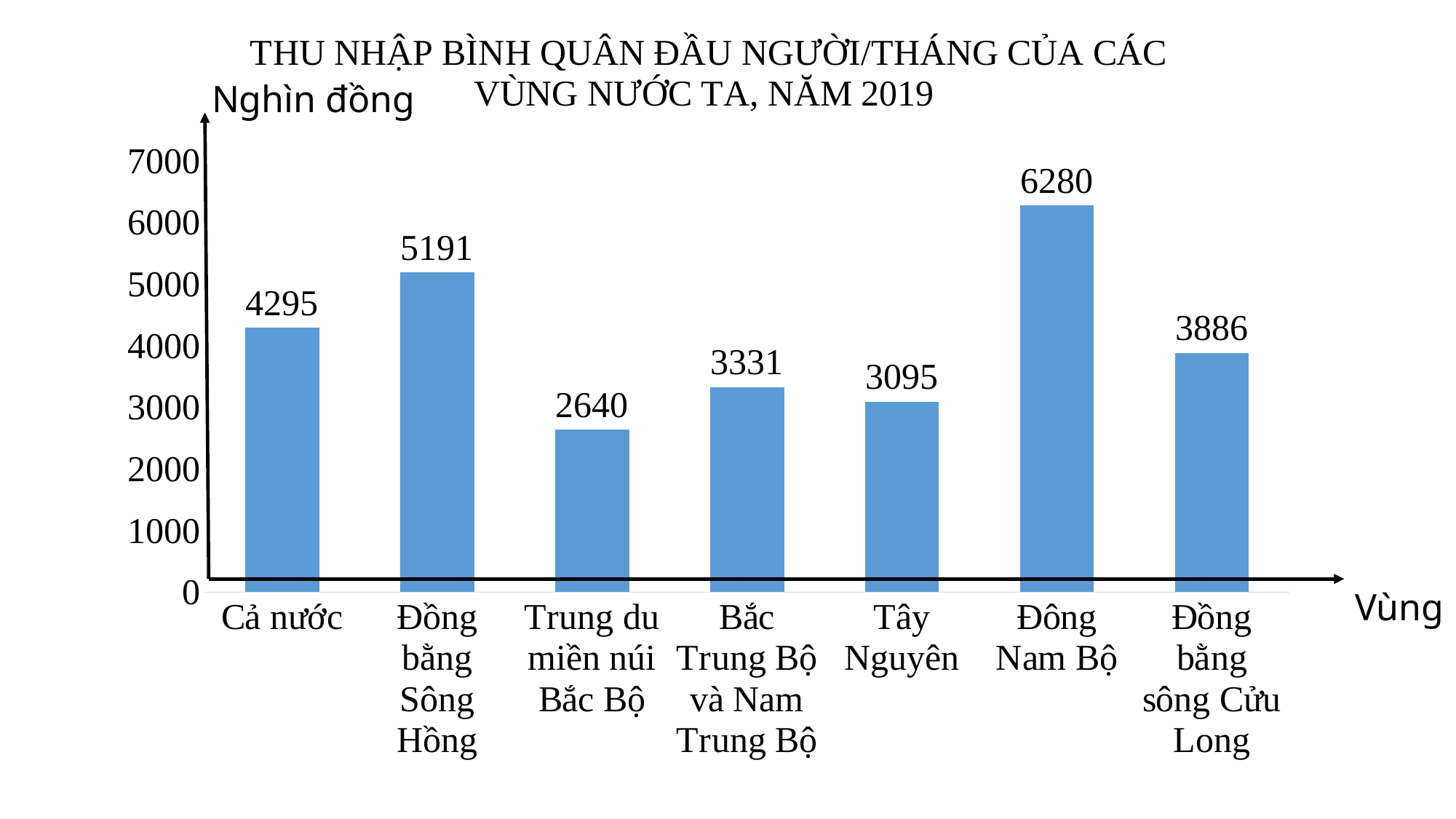
Which region has the highest value? Đông Nam Bộ Which is larger, the value for Bắc Trung Bộ và Nam Trung Bộ or the value for Tây Nguyên? Bắc Trung Bộ và Nam Trung Bộ What is the difference between the values for Đồng bằng Sông Hồng and Tây Nguyên? 2096 What is the difference between the values for Đông Nam Bộ and Cả nước? 1985 What is the value for Đồng bằng sông Cửu Long? 3886 Which region has the lowest value? Trung du miền núi Bắc Bộ What unit is shown on the vertical axis? Nghìn đồng What kind of chart is this? bar chart Is the value for Đồng bằng Sông Hồng greater or less than 5000? greater What is the value for Đông Nam Bộ? 6280 How many categories are shown on the x axis? 7 What is the value for Trung du miền núi Bắc Bộ? 2640